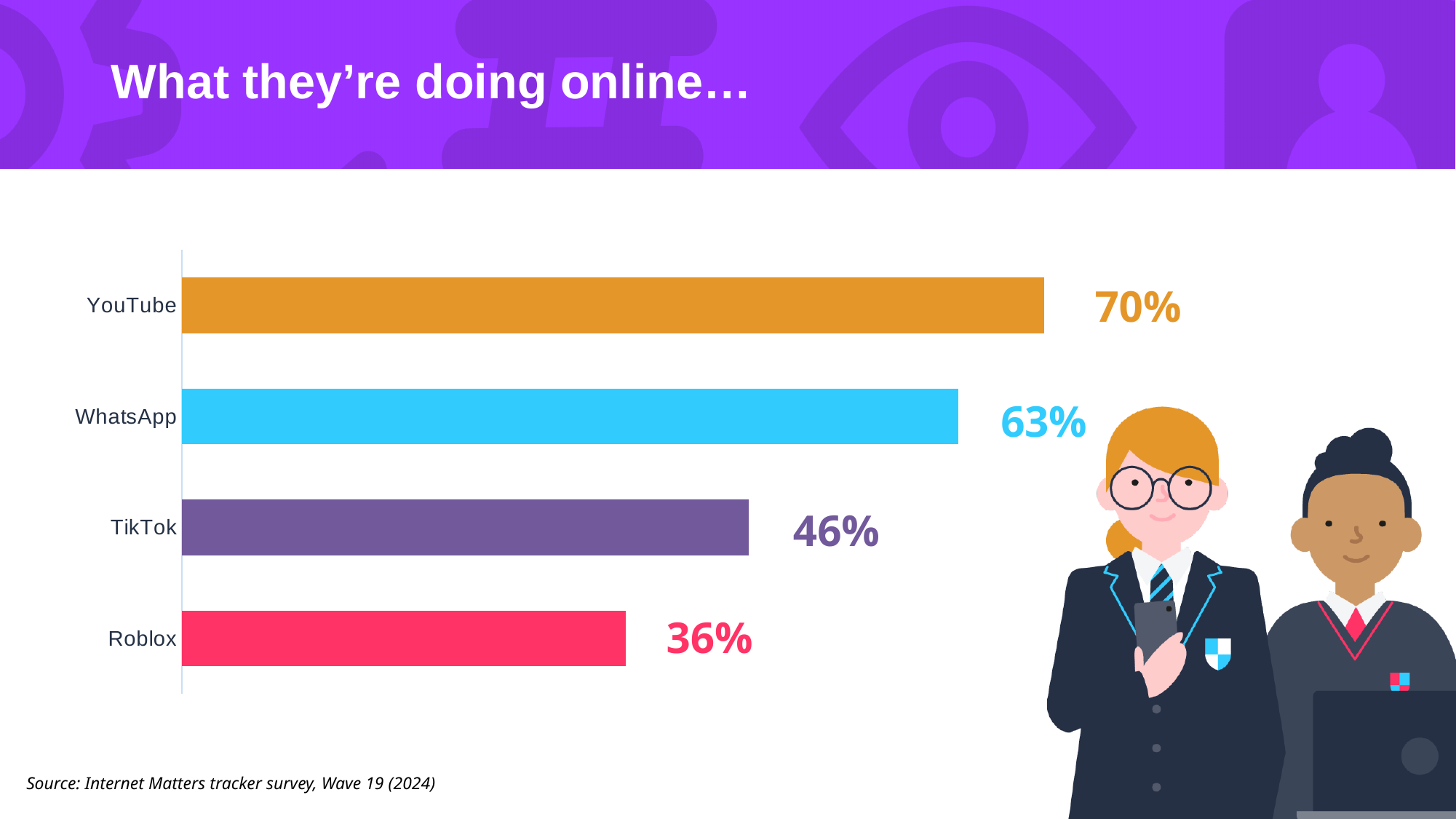
What is the title of the slide containing the chart? What they're doing online… Which category has the lowest value? Roblox What is the value for YouTube? 70% What is the difference between the values for TikTok and Roblox? 10% Which has a larger value, WhatsApp or TikTok? WhatsApp What is the value for TikTok? 46% Which category has the highest value? YouTube How many categories are shown in the chart? 4 What is the difference between the values for YouTube and WhatsApp? 7% What kind of chart is shown on the slide? Bar chart What is the value for Roblox? 36% What is the value for WhatsApp? 63%